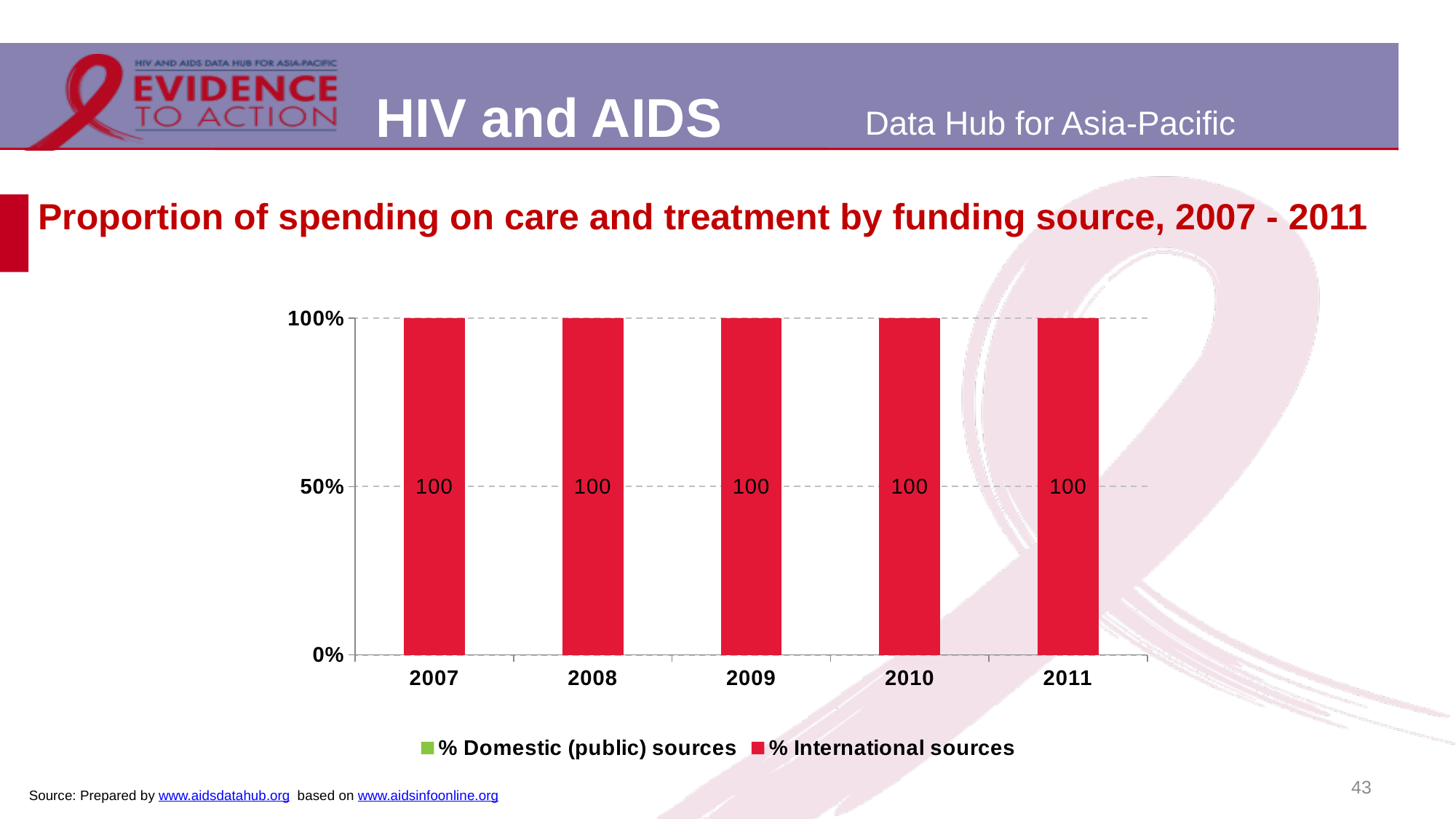
What is the first year shown on the x axis? 2007 What is the value for % International sources in 2007? 100 Which series is shown in red in the legend? % International sources Does the value for % International sources rise, fall or stay the same from 2007 to 2011? stays the same What is the value for % International sources in 2011? 100 What is the title of the chart? Proportion of spending on care and treatment by funding source, 2007 - 2011 How many series does the legend list? 2 How many years are shown on the x axis? 5 What is the value for % International sources in 2009? 100 What kind of chart is shown on the slide? bar chart What is the difference between the % International sources values for 2008 and 2010? 0 Is the value for % International sources in 2010 greater or less than 50%? greater